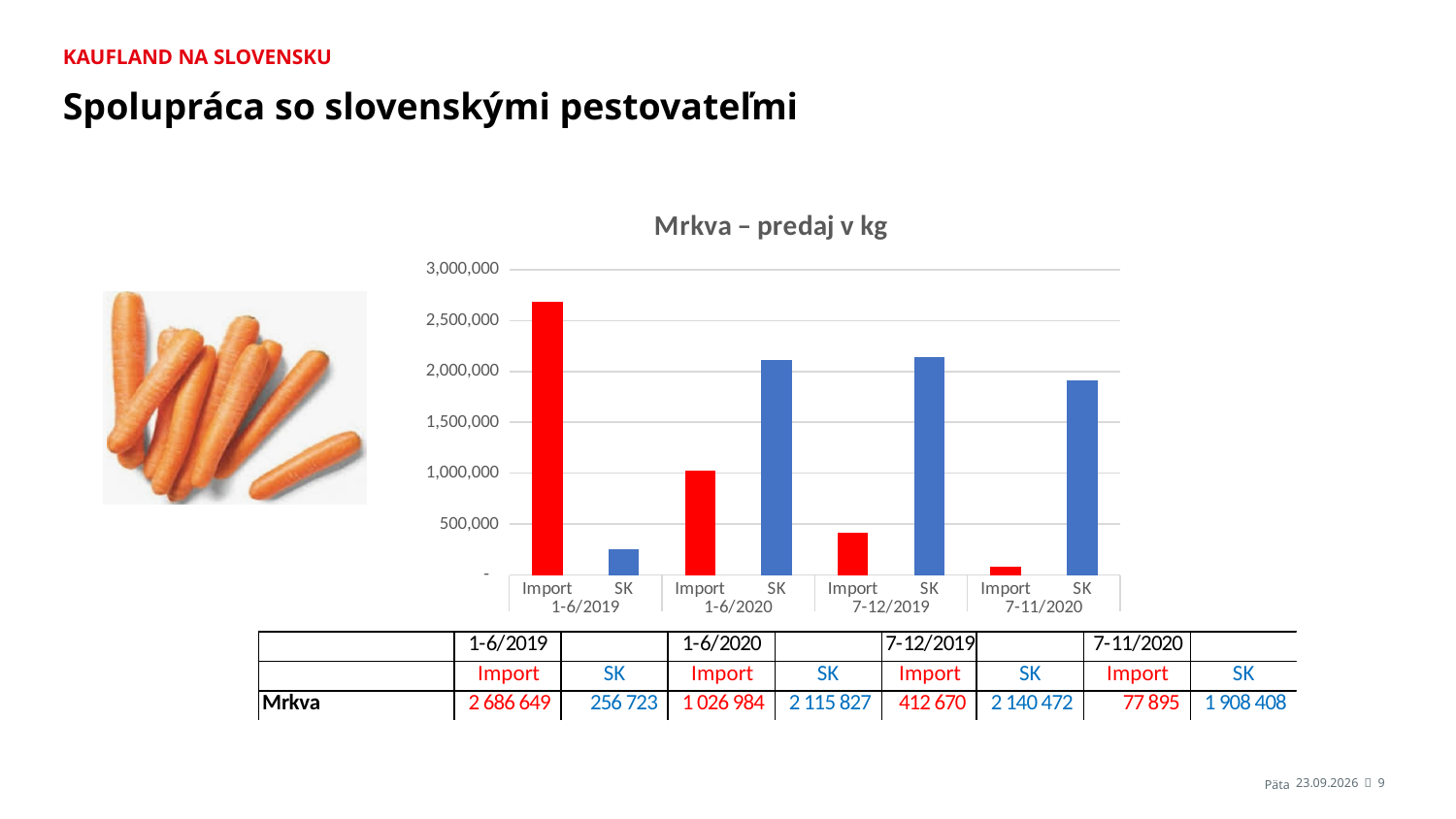
Which bar has the lowest value in the chart? Import 7-11/2020 What is the difference between the Import values for 1-6/2020 and 7-12/2019? 614 314 What is the title of the chart? Mrkva – predaj v kg Which bar has the highest value in the chart? Import 1-6/2019 What type of chart is shown on the slide? bar chart For the period 1-6/2020, which is larger, Import or SK? SK Do the Import values rise or fall across the periods from left to right? fall What is the difference between the Import and SK values for 1-6/2019? 2 429 926 What is the SK value for the period 1-6/2020? 2 115 827 Is the Import value for 1-6/2019 greater or less than 2,500,000? greater What is the Import value for the period 1-6/2019? 2 686 649 What is the SK value for the period 7-11/2020? 1 908 408